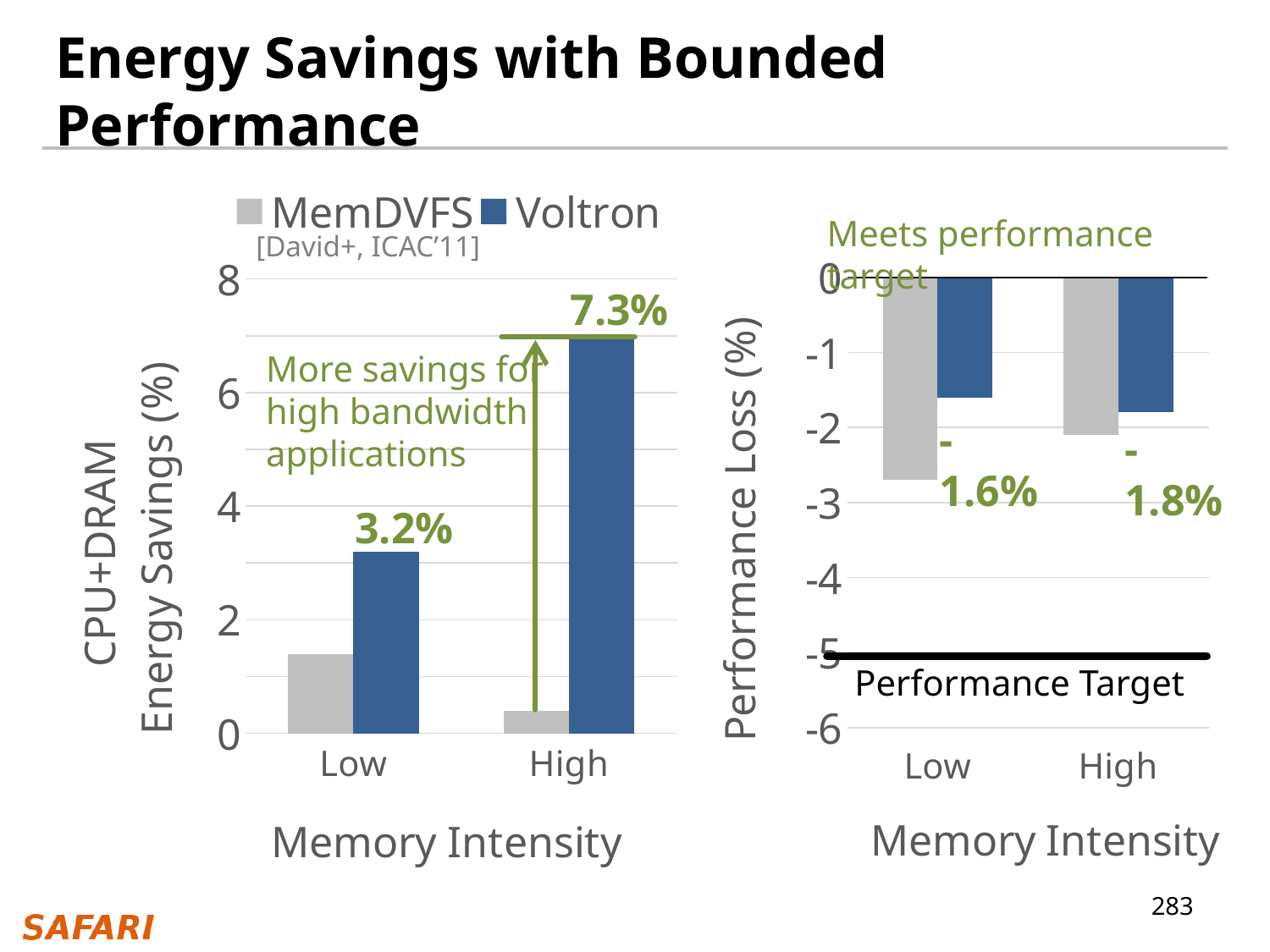
In the left chart (CPU+DRAM Energy Savings), which series has the higher energy savings at High memory intensity, MemDVFS or Voltron? Voltron What kind of chart is the left chart (CPU+DRAM Energy Savings)? Bar chart In the left chart (CPU+DRAM Energy Savings), what is the energy savings value for Voltron at High memory intensity? 7.3% In the right chart (Performance Loss), is the value for MemDVFS at Low memory intensity greater or less than -2? less In the left chart (CPU+DRAM Energy Savings), what is the energy savings value for Voltron at Low memory intensity? 3.2% In the right chart (Performance Loss), what is the performance loss value for Voltron at Low memory intensity? -1.6% How many memory intensity categories are shown on the x axis of the left chart (CPU+DRAM Energy Savings)? 2 How many series does the legend list for the charts on this slide? 2 In the left chart (CPU+DRAM Energy Savings), do Voltron's energy savings rise or fall from Low to High memory intensity? rise In the left chart (CPU+DRAM Energy Savings), what is the difference between Voltron's energy savings at High and at Low memory intensity? 4.1% In the right chart (Performance Loss), what is the performance loss value for Voltron at High memory intensity? -1.8% In the left chart (CPU+DRAM Energy Savings), is the value for MemDVFS at Low memory intensity greater or less than 2? less